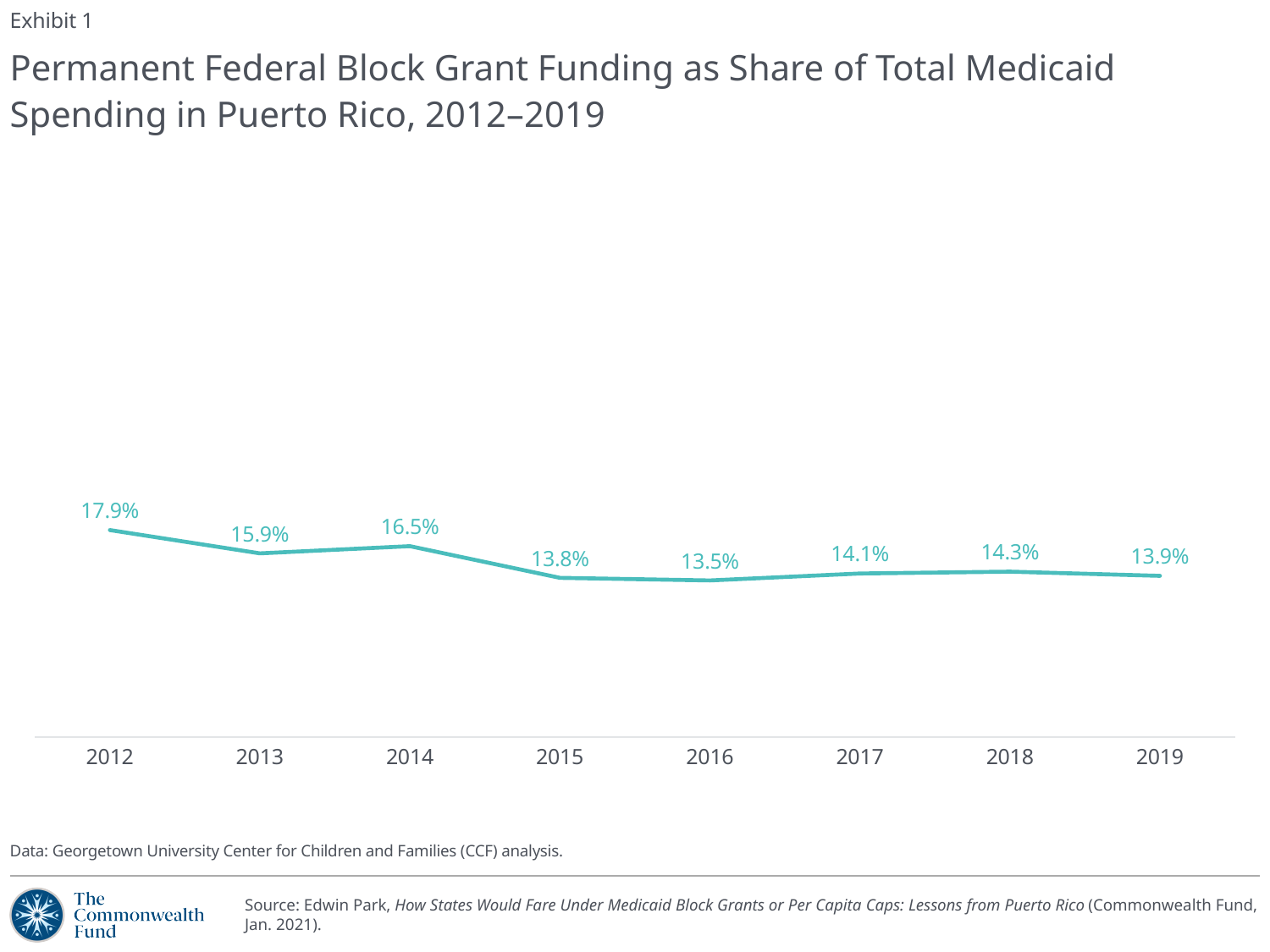
What value is shown for 2019? 13.9% What is the difference between the 2014 value and the 2015 value? 2.7 percentage points How many years are plotted on the chart? 8 What kind of chart is shown? Line chart Which year has the highest share? 2012 Which is larger, the value for 2017 or the value for 2018? 2018 Which is larger, the value for 2013 or the value for 2014? 2014 Overall, does the share rise or fall from 2012 to 2019? Fall What is the difference between the 2012 value and the 2019 value? 4.0 percentage points What was the permanent federal block grant funding share of total Medicaid spending in Puerto Rico in 2012? 17.9% Which year has the lowest share? 2016 What value is shown for 2016? 13.5%